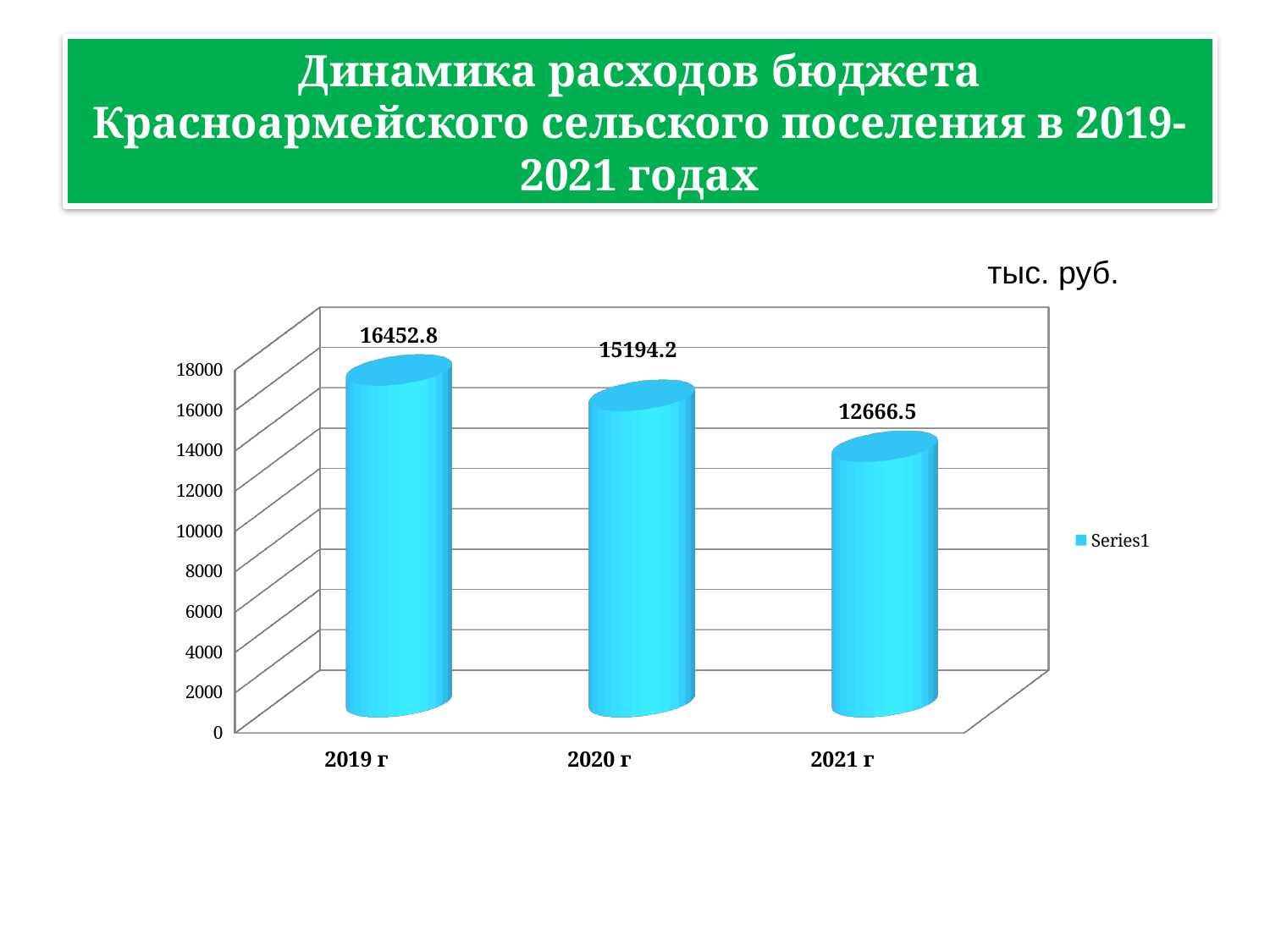
What is the difference between the values for 2019 г and 2021 г? 3786.3 How many series does the legend list? 1 What is the difference between the values for 2019 г and 2020 г? 1258.6 How many categories are shown on the x axis? 3 Which is larger, the value for 2020 г or the value for 2021 г? 2020 г Do the values rise or fall from 2019 г to 2021 г? fall What is the value for 2021 г? 12666.5 What is the value for 2020 г? 15194.2 Which year has the highest value? 2019 г Which year has the lowest value? 2021 г What kind of chart is shown on the slide? bar chart What is the value for 2019 г? 16452.8